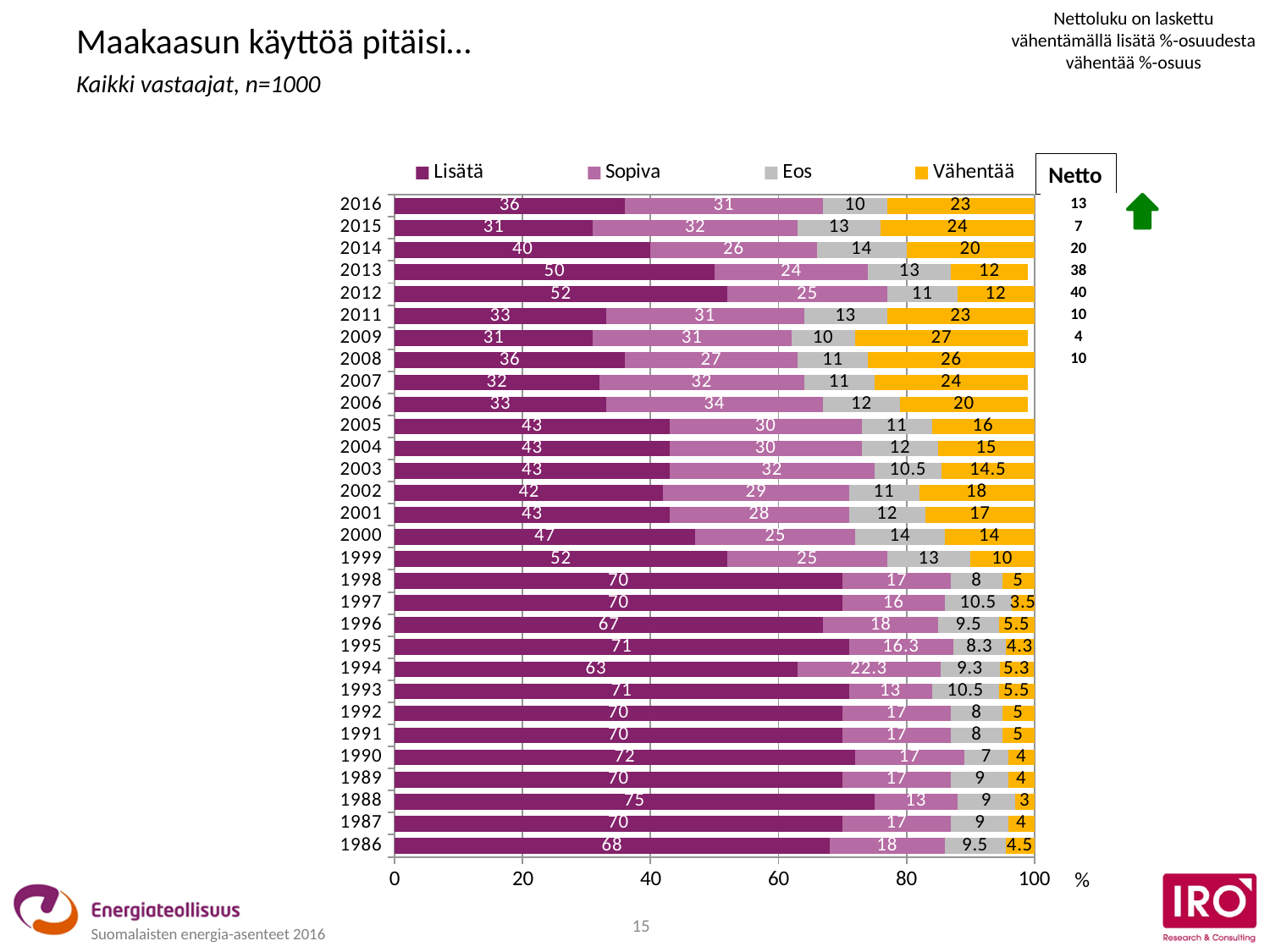
What is the difference between the Lisätä and Vähentää values for 2016? 13 What is the Lisätä value for 2016? 36 What is the total of the stacked bar for 2016? 100 What is the Vähentää value for 2009? 27 What kind of chart is shown on the slide? Stacked bar chart What Netto value is shown next to the 2012 bar? 40 What is the Eos value for 1994? 9.3 How many series does the legend list? 4 How many years (categories) are shown in the chart? 30 In which year is the Lisätä share highest? 1988 In which year is the Vähentää share lowest? 1988 Which year has a larger Lisätä value, 2012 or 2013? 2012